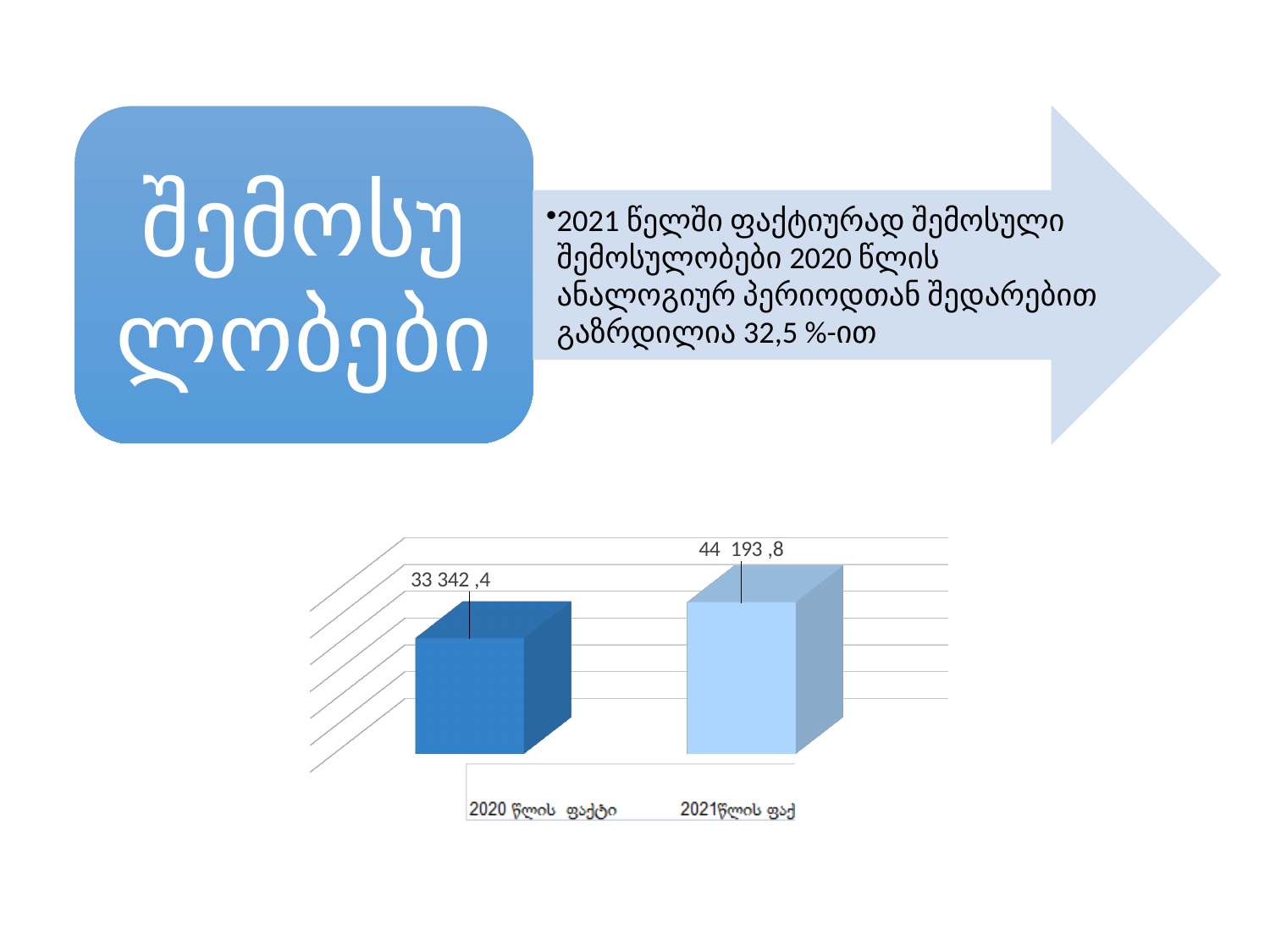
Do the values rise or fall from 2020 to 2021? Rise What is the value shown for 2020 წლის ფაქტი? 33 342 ,4 What kind of chart is shown on the slide? Bar chart Which category has the lowest value? 2020 წლის ფაქტი What is the label of the first (left) category on the x axis? 2020 წლის ფაქტი Which is larger, the 2020 value or the 2021 value? 2021 Which bar is drawn in the darker blue colour? 2020 წლის ფაქტი Which category has the highest value? 2021 What is the value shown for the 2021 bar? 44 193 ,8 How many bars are plotted in the chart? 2 What is the difference between the 2021 value and the 2020 value? 10 851,4